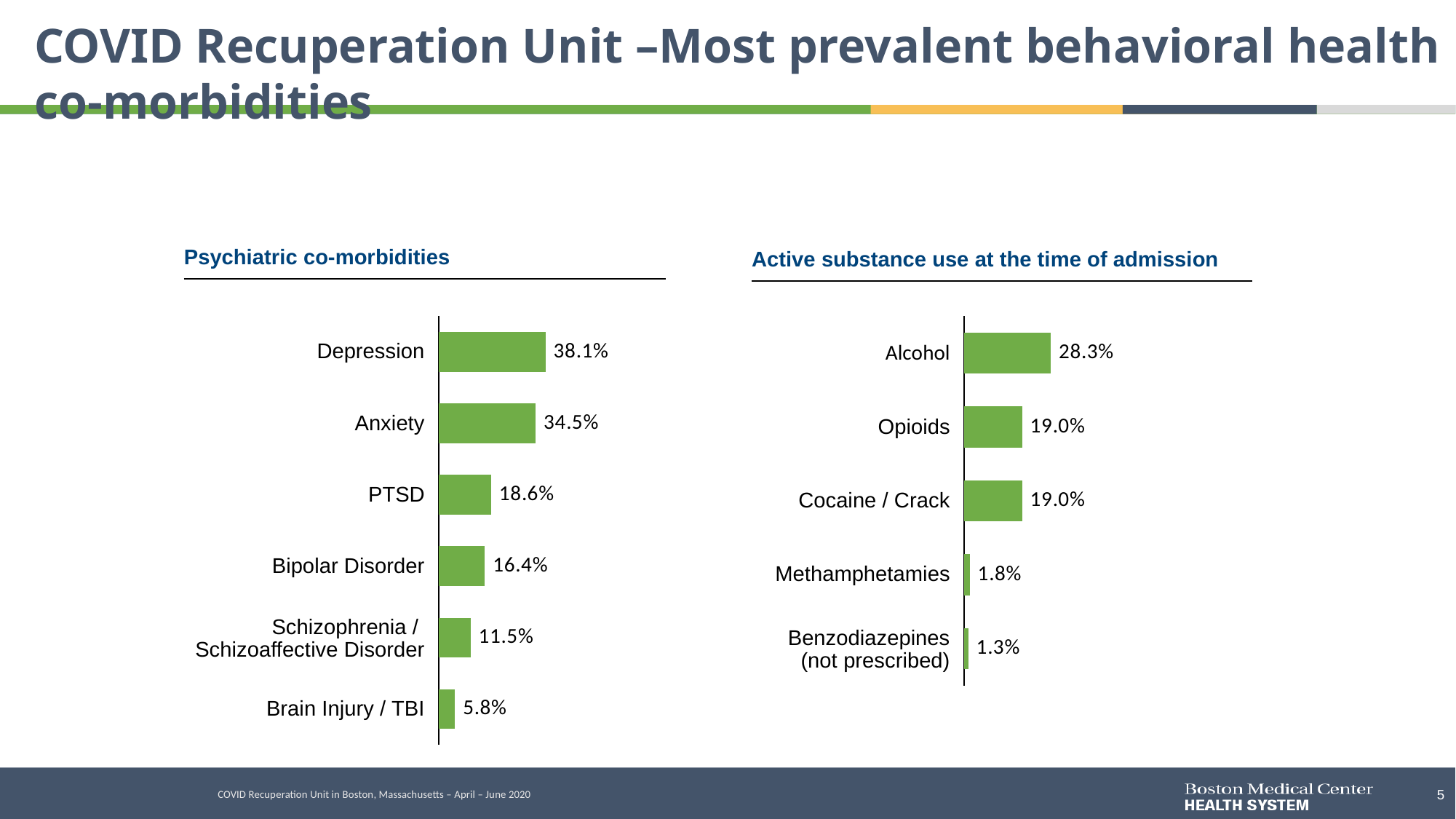
In the Psychiatric co-morbidities chart, which category has the lowest value? Brain Injury / TBI In the Active substance use at the time of admission chart, what is the value for Benzodiazepines (not prescribed)? 1.3% In the Active substance use at the time of admission chart, which category has the highest value? Alcohol In the Active substance use at the time of admission chart, what is the difference between the values for Alcohol and Opioids? 9.3% In the Psychiatric co-morbidities chart, what is the value for Schizophrenia / Schizoaffective Disorder? 11.5% How many categories are shown in the Active substance use at the time of admission chart? 5 In the Psychiatric co-morbidities chart, what is the difference between the values for Depression and Anxiety? 3.6% What kind of chart is the Active substance use at the time of admission chart? Bar chart In the Active substance use at the time of admission chart, what is the value for Alcohol? 28.3% In the Psychiatric co-morbidities chart, which is larger, the value for PTSD or the value for Bipolar Disorder? PTSD In the Psychiatric co-morbidities chart, what is the value for Depression? 38.1% How many categories are shown in the Psychiatric co-morbidities chart? 6